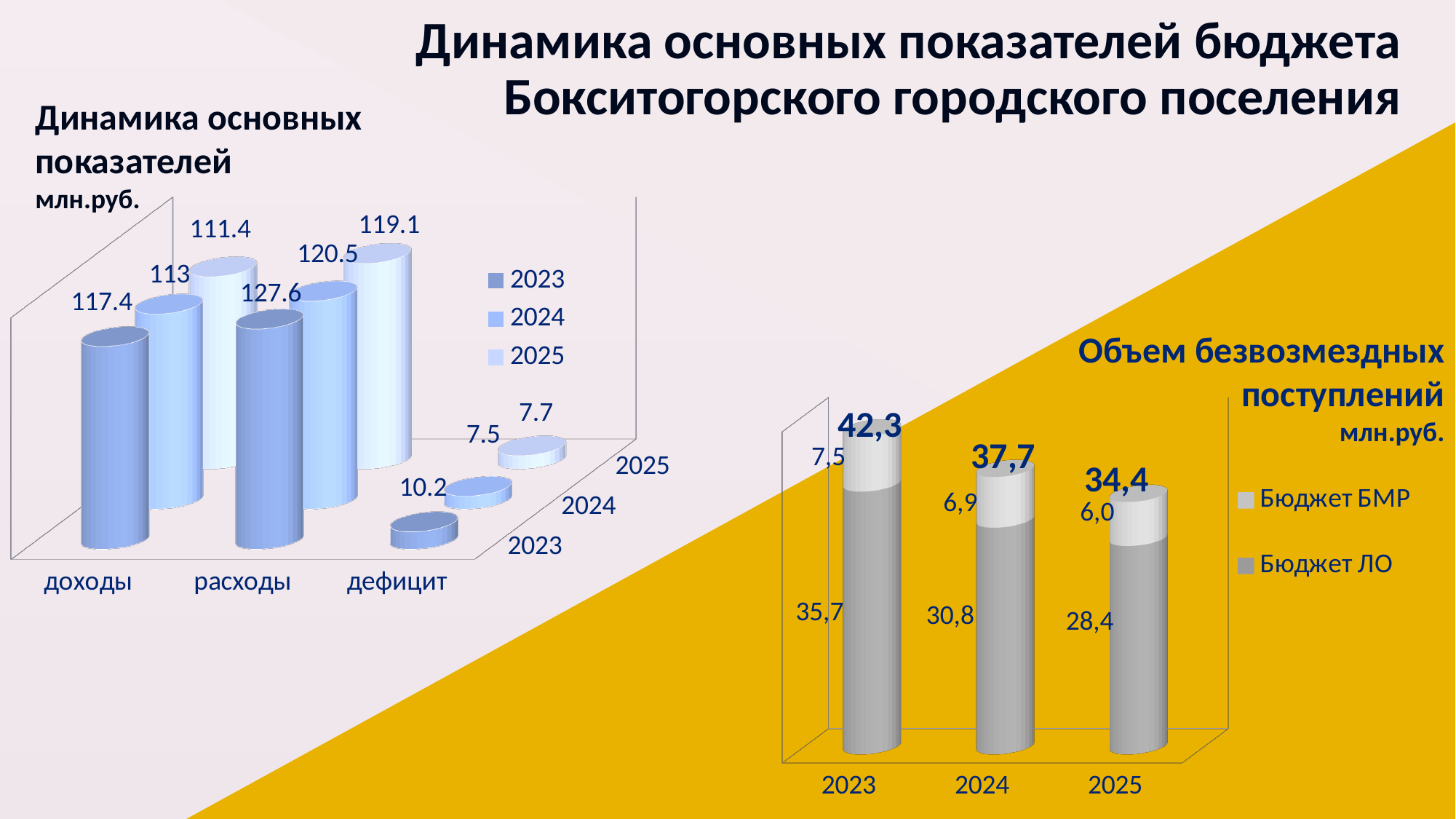
In the chart 'Динамика основных показателей', what is the difference between расходы and доходы in 2023? 10.2 In the chart 'Динамика основных показателей', which year has the highest value for расходы? 2023 In the chart 'Объем безвозмездных поступлений', what is the total of the stacked bar for 2023? 42,3 In the chart 'Объем безвозмездных поступлений', what is the difference between Бюджет ЛО and Бюджет БМР in 2025? 22,4 In the chart 'Динамика основных показателей', do the values for доходы rise or fall from 2023 to 2025? fall In the chart 'Объем безвозмездных поступлений', which year has the lowest total? 2025 In the chart 'Динамика основных показателей', what is the value for дефицит in 2024? 7.5 In the chart 'Объем безвозмездных поступлений', what is the value for Бюджет ЛО in 2024? 30,8 In the chart 'Динамика основных показателей', how many series does the legend list? 3 In the chart 'Динамика основных показателей', what is the value for доходы in 2023? 117.4 In the chart 'Динамика основных показателей', what is the value for расходы in 2025? 119.1 What kind of chart is 'Объем безвозмездных поступлений'? stacked bar chart